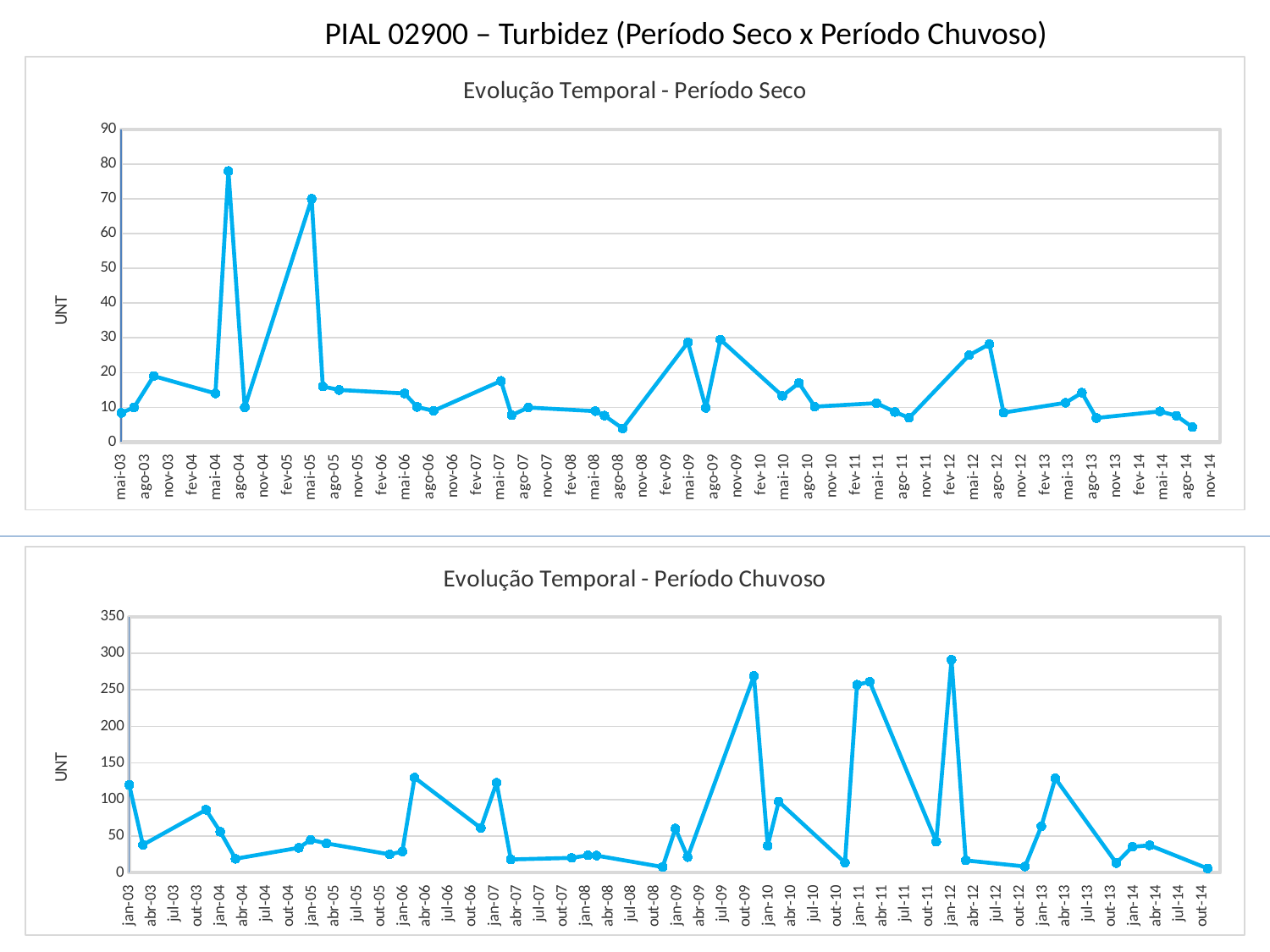
In the 'Evolução Temporal - Período Chuvoso' chart, is the value for jan-12 greater or less than 250? greater What kind of chart is the 'Evolução Temporal - Período Seco' chart? line chart In the 'Evolução Temporal - Período Seco' chart, is the value for mai-12 greater or less than 20? greater In the 'Evolução Temporal - Período Chuvoso' chart, is the value for out-08 greater or less than 50? less What is the label on the vertical axis of the 'Evolução Temporal - Período Chuvoso' chart? UNT In the 'Evolução Temporal - Período Chuvoso' chart, which is larger, the value for jan-12 or the value for jan-10? jan-12 In the 'Evolução Temporal - Período Seco' chart, which is larger, the value for mai-04 or the value for mai-05? mai-05 In the 'Evolução Temporal - Período Chuvoso' chart, which date has the highest value? jan-12